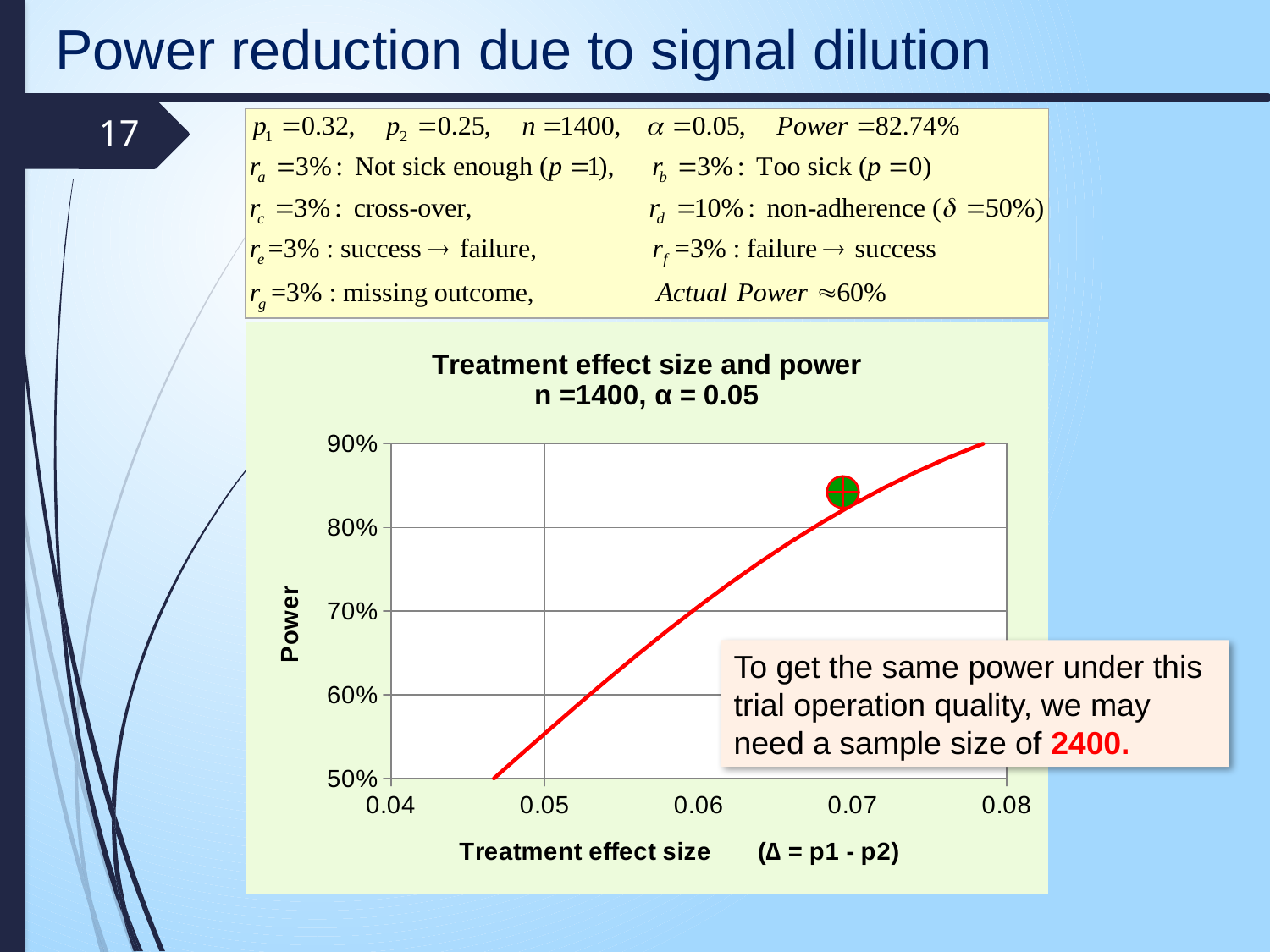
Is the power at a treatment effect size of 0.05 greater or less than 60%? less How many tick values are labelled on the horizontal axis of the chart? 5 Which has higher power on the curve: a treatment effect size of 0.05 or 0.07? 0.07 What kind of chart is shown on the slide? line chart What is the title of the chart? Treatment effect size and power n =1400, α = 0.05 Does power rise or fall as treatment effect size increases along the x axis? rise Is the power at a treatment effect size of 0.05 greater or less than 50%? greater What is the lowest value shown on the vertical axis of the chart? 50% Is the power at a treatment effect size of 0.07 greater or less than 80%? greater What is the label of the vertical axis of the chart? Power